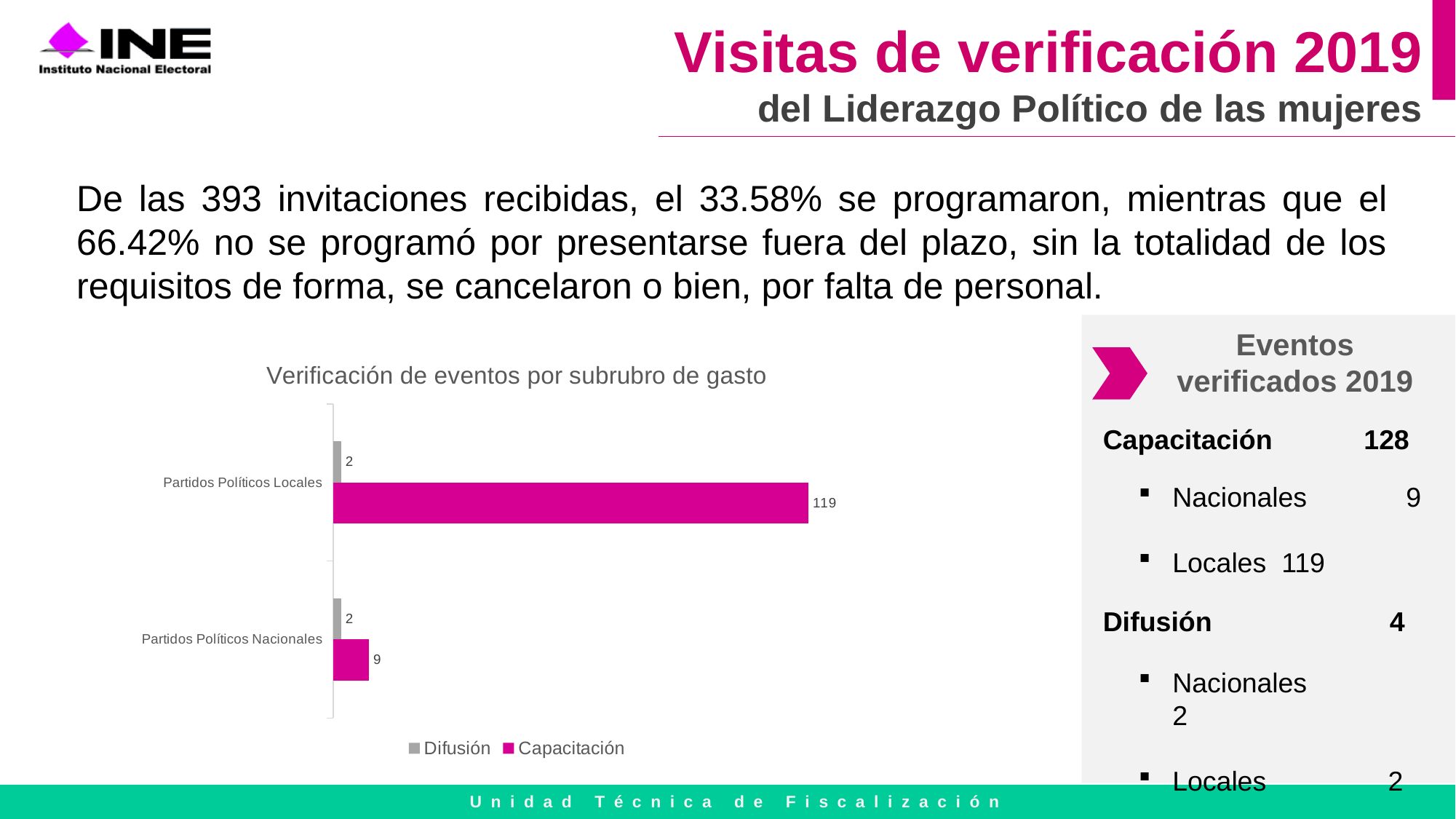
What is the Difusión value for Partidos Políticos Locales? 2 Which is larger for Partidos Políticos Nacionales: Difusión or Capacitación? Capacitación What is the title of the chart? Verificación de eventos por subrubro de gasto What is the Capacitación value for Partidos Políticos Nacionales? 9 What kind of chart is shown on the slide? Bar chart What is the Difusión value for Partidos Políticos Nacionales? 2 What is the Capacitación value for Partidos Políticos Locales? 119 What is the difference between the Capacitación values for Partidos Políticos Locales and Partidos Políticos Nacionales? 110 How many series does the legend list? 2 Which category has the highest Capacitación value? Partidos Políticos Locales Which category has the lowest Capacitación value? Partidos Políticos Nacionales How many categories are shown on the chart? 2